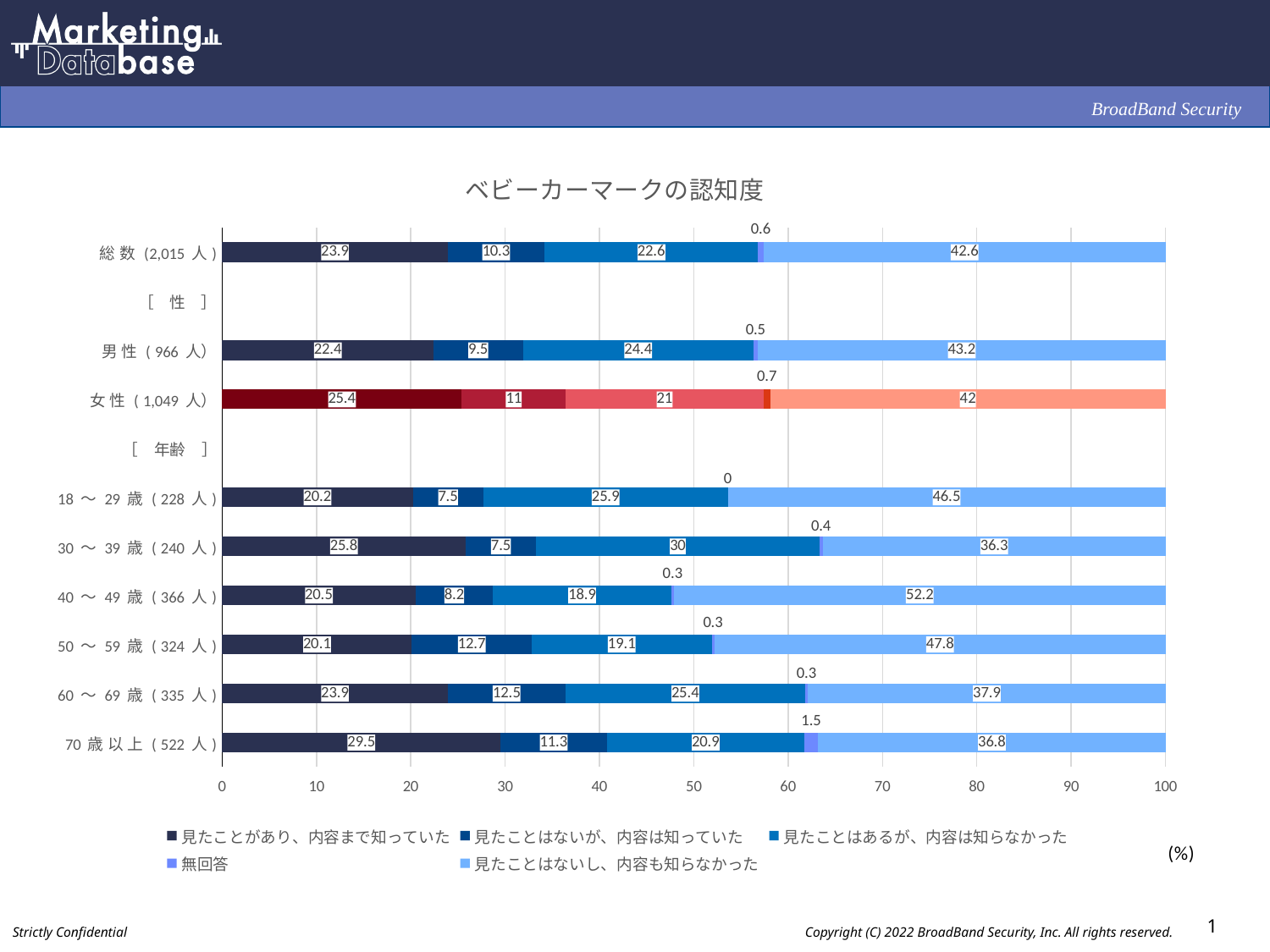
What is the value of 見たことはないし、内容も知らなかった for 40〜49歳 (366人)? 52.2 Which age group has the highest value for 見たことがあり、内容まで知っていた? 70歳以上 (522人) Which is larger, the 見たことはあるが、内容は知らなかった value for 30〜39歳 (240人) or for 18〜29歳 (228人)? 30〜39歳 (240人) What is the value of 見たことはないが、内容は知っていた for 50〜59歳 (324人)? 12.7 How many series does the legend list? 5 What is the title of the chart? ベビーカーマークの認知度 Which age group has the lowest value for 見たことはないし、内容も知らなかった? 30〜39歳 (240人) What is the value of 無回答 for 18〜29歳 (228人)? 0 What is the difference between the 見たことはないし、内容も知らなかった values for 男性 (966人) and 女性 (1,049人)? 1.2 What is the value of 無回答 for 70歳以上 (522人)? 1.5 What type of chart is shown on the slide? Stacked bar chart What is the value of 見たことがあり、内容まで知っていた for 総数 (2,015人)? 23.9